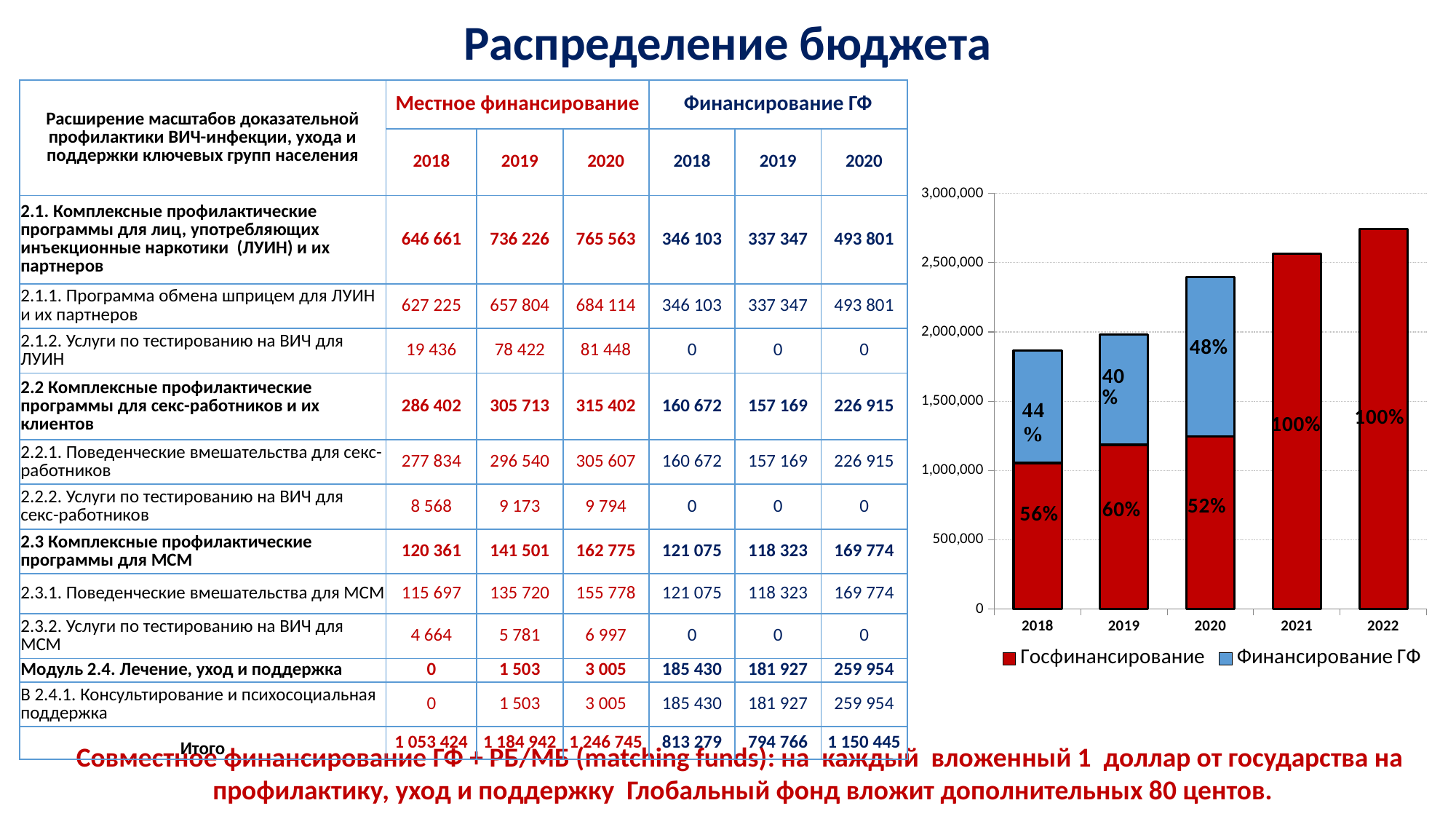
In the bar chart, which year has the shortest total bar? 2018 In the bar chart, which year has the tallest total bar? 2022 In the bar chart, do the total bar heights rise or fall from 2018 to 2022? rise How many series does the legend of the bar chart list? 2 In the bar chart, is the Госфинансирование share larger in 2019 or in 2020? 2019 In the bar chart, is the total bar for 2022 greater or less than 2,500,000? greater In the bar chart, what percentage label is shown for Госфинансирование in 2018? 56% In the bar chart, is the total bar for 2018 greater or less than 2,000,000? less What kind of chart is shown on the right of the slide? bar chart In the bar chart, what percentage label is shown for Госфинансирование in 2021? 100% How many years are shown on the x axis of the bar chart? 5 In the bar chart, what percentage label is shown for Финансирование ГФ in 2020? 48%